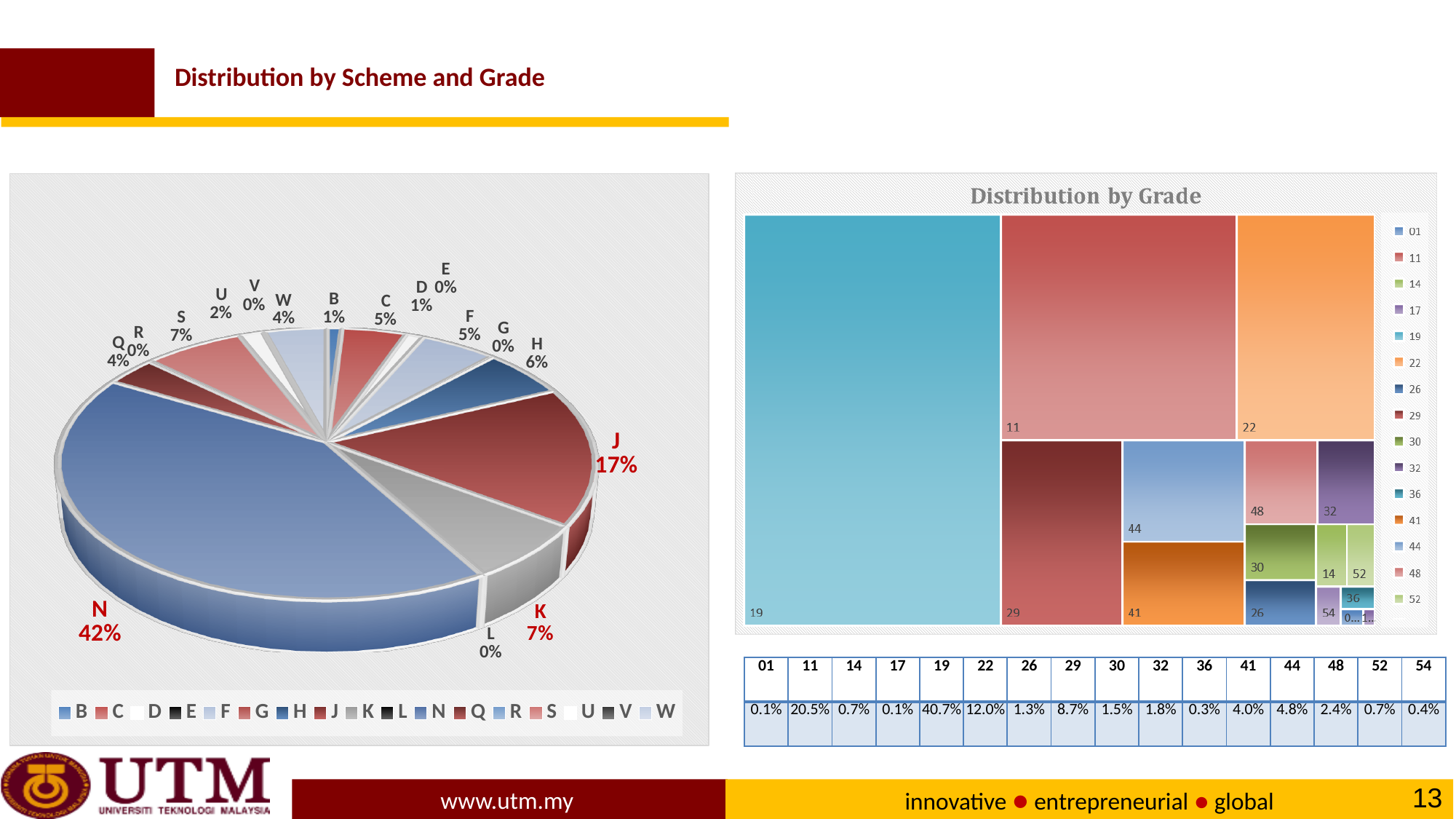
In the 'Distribution by Grade' chart, which is larger, the share for grade 22 or the share for grade 29? 22 In the pie chart on the left, how many categories does the legend list? 17 In the pie chart on the left, what is the difference in percentage points between N and J? 25 In the pie chart on the left, what percentage does category N account for? 42% In the 'Distribution by Grade' chart, what percentage is shown for grade 11 in the table below it? 20.5% What is the title of the chart on the right of the slide? Distribution by Grade What kind of chart is shown on the left of the slide? Pie chart In the pie chart on the left, what percentage does category J account for? 17% In the 'Distribution by Grade' chart, what percentage is shown for grade 19 in the table below it? 40.7% In the pie chart on the left, which is larger, the share for K or the share for H? K In the 'Distribution by Grade' chart, which grade has the largest share according to the table? 19 In the pie chart on the left, which category has the largest share? N